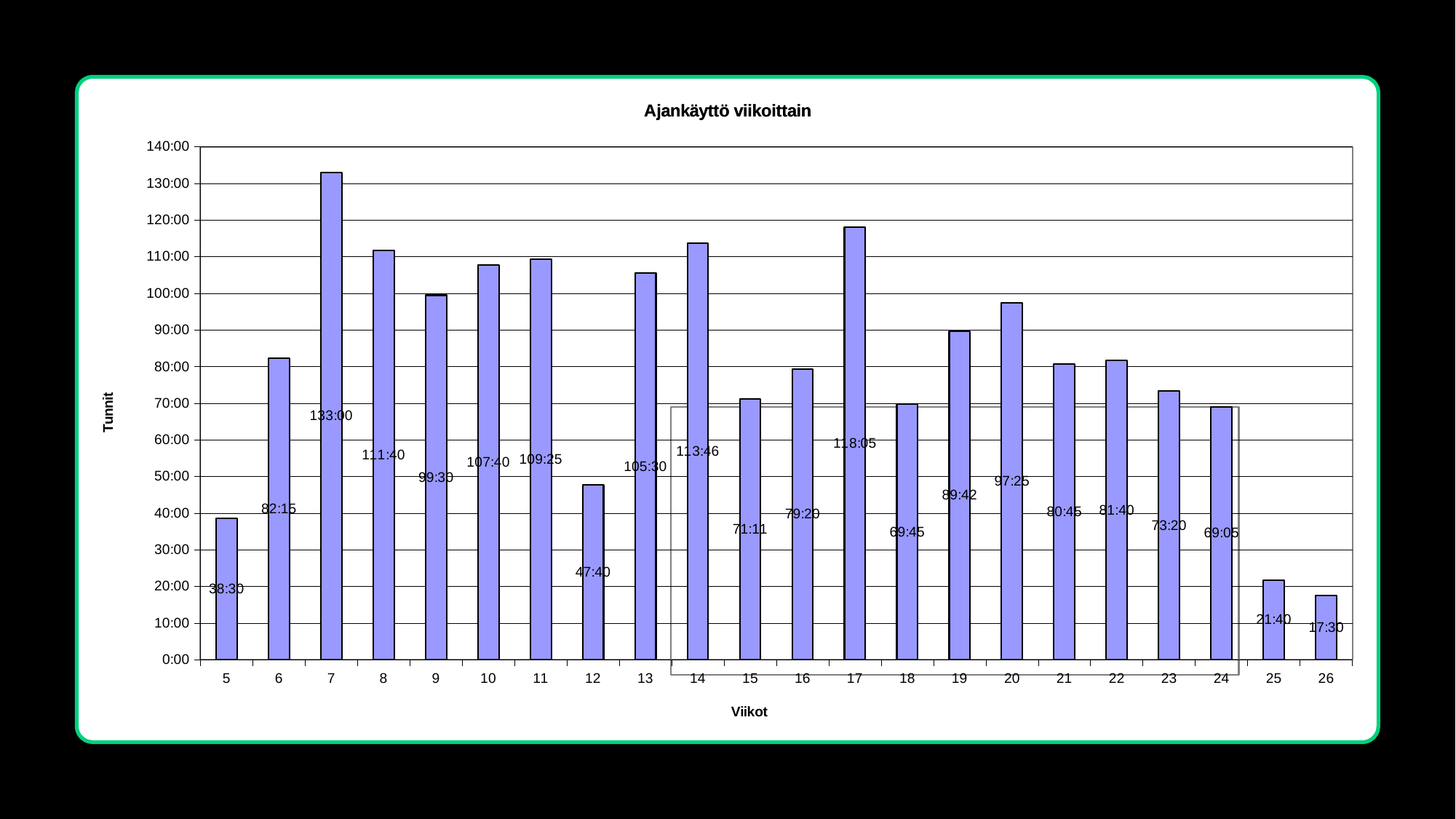
How many weeks are shown on the x axis? 22 What is the value for week 25? 21:40 Which is larger, the value for week 12 or the value for week 13? week 13 What is the value for week 14? 113:46 Which week has the highest value? 7 What is the difference between the value for week 7 and the value for week 5? 94:30 What is the label of the y axis? Tunnit What is the value for week 7? 133:00 What is the title of the chart? Ajankäyttö viikoittain Is the value for week 12 greater or less than 50:00? less What kind of chart is shown on the slide? bar chart Which week has the lowest value? 26